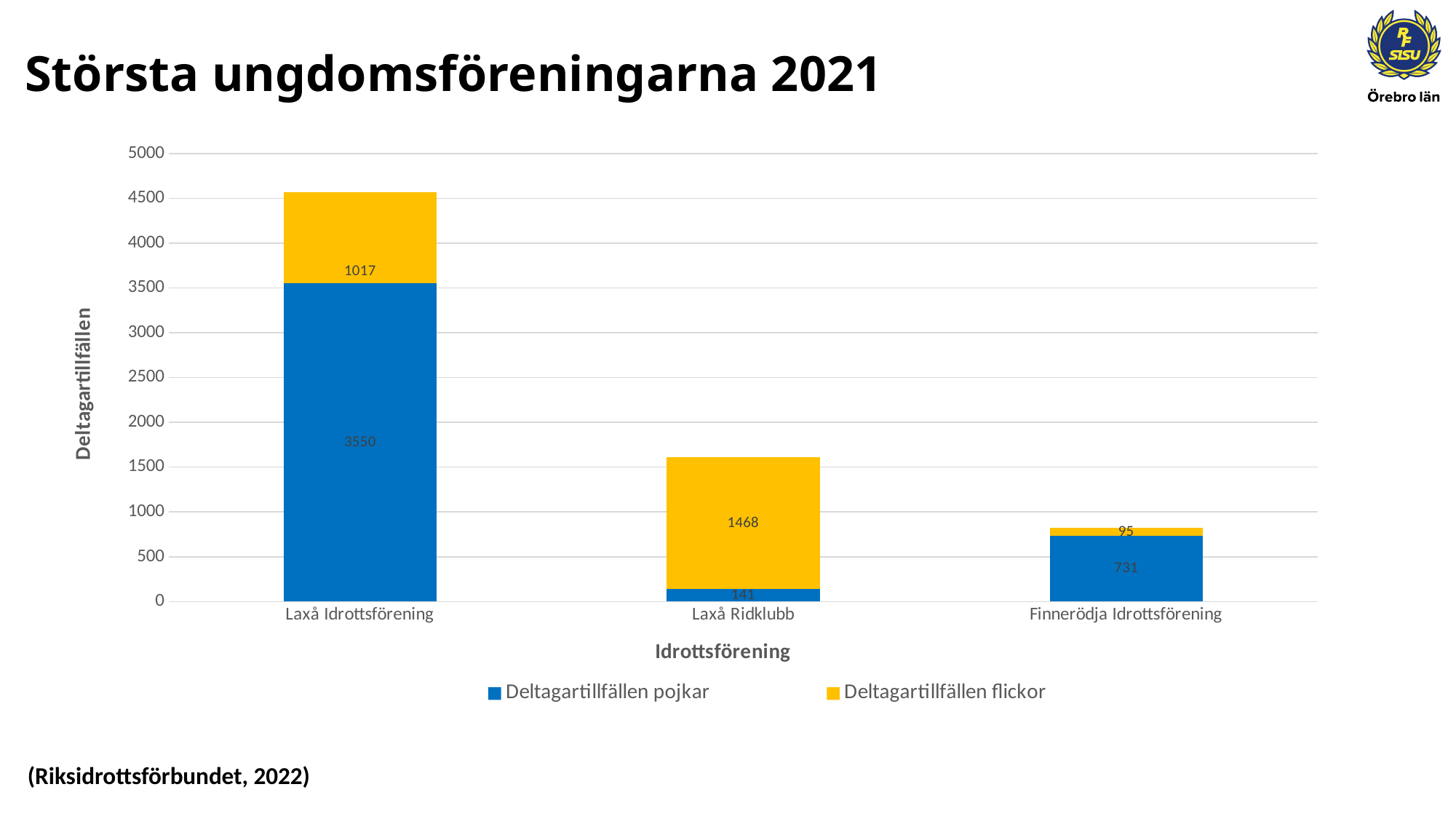
What kind of chart is shown on the slide? Stacked bar chart What is the difference between Deltagartillfällen pojkar and Deltagartillfällen flickor for Laxå Idrottsförening? 2533 Which category has the highest value for Deltagartillfällen pojkar? Laxå Idrottsförening What is the value of Deltagartillfällen flickor for Laxå Ridklubb? 1468 How many categories are shown on the x axis? 3 What is the value of Deltagartillfällen pojkar for Laxå Idrottsförening? 3550 What is the total of the stacked bar for Finnerödja Idrottsförening? 826 What is the value of Deltagartillfällen flickor for Finnerödja Idrottsförening? 95 What is the value of Deltagartillfällen pojkar for Laxå Ridklubb? 141 Which category has the lowest value for Deltagartillfällen flickor? Finnerödja Idrottsförening How many series does the legend list? 2 Which is larger for Laxå Ridklubb: Deltagartillfällen pojkar or Deltagartillfällen flickor? Deltagartillfällen flickor